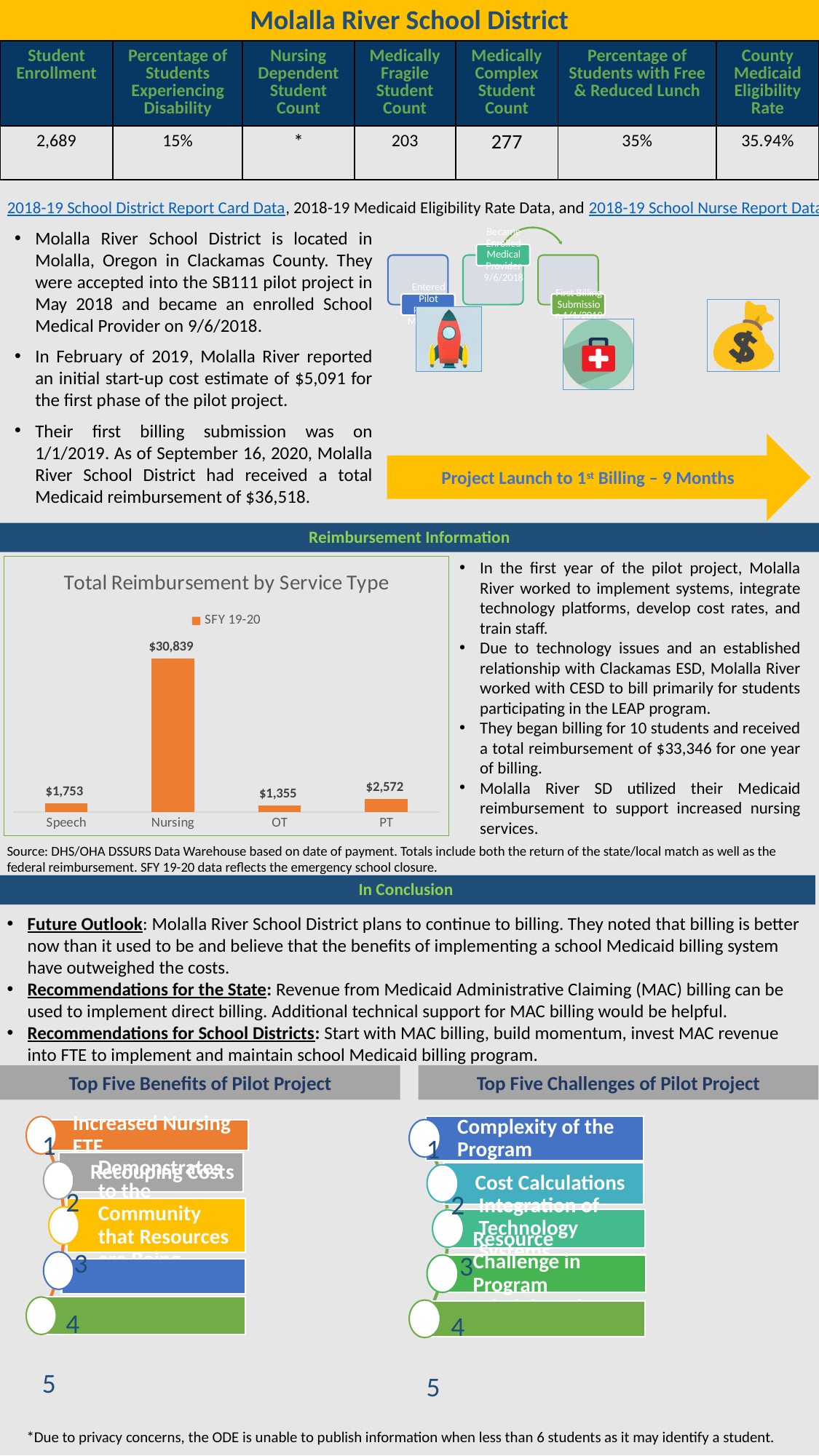
In the 'Total Reimbursement by Service Type' chart, what is the value for PT? $2,572 In the 'Total Reimbursement by Service Type' chart, what is the difference between the Nursing and PT values? $28,267 What type of chart is 'Total Reimbursement by Service Type'? bar chart How many service type categories are shown in the 'Total Reimbursement by Service Type' chart? 4 Which service type has the lowest total reimbursement in the chart? OT Which service type has the highest total reimbursement in the chart? Nursing How many series does the legend of the 'Total Reimbursement by Service Type' chart list? 1 In the 'Total Reimbursement by Service Type' chart, which is larger, the value for Speech or the value for PT? PT What is the title of the chart on the slide? Total Reimbursement by Service Type In the 'Total Reimbursement by Service Type' chart, what is the value for Speech? $1,753 In the 'Total Reimbursement by Service Type' chart, what is the value for Nursing? $30,839 In the 'Total Reimbursement by Service Type' chart, what is the value for OT? $1,355